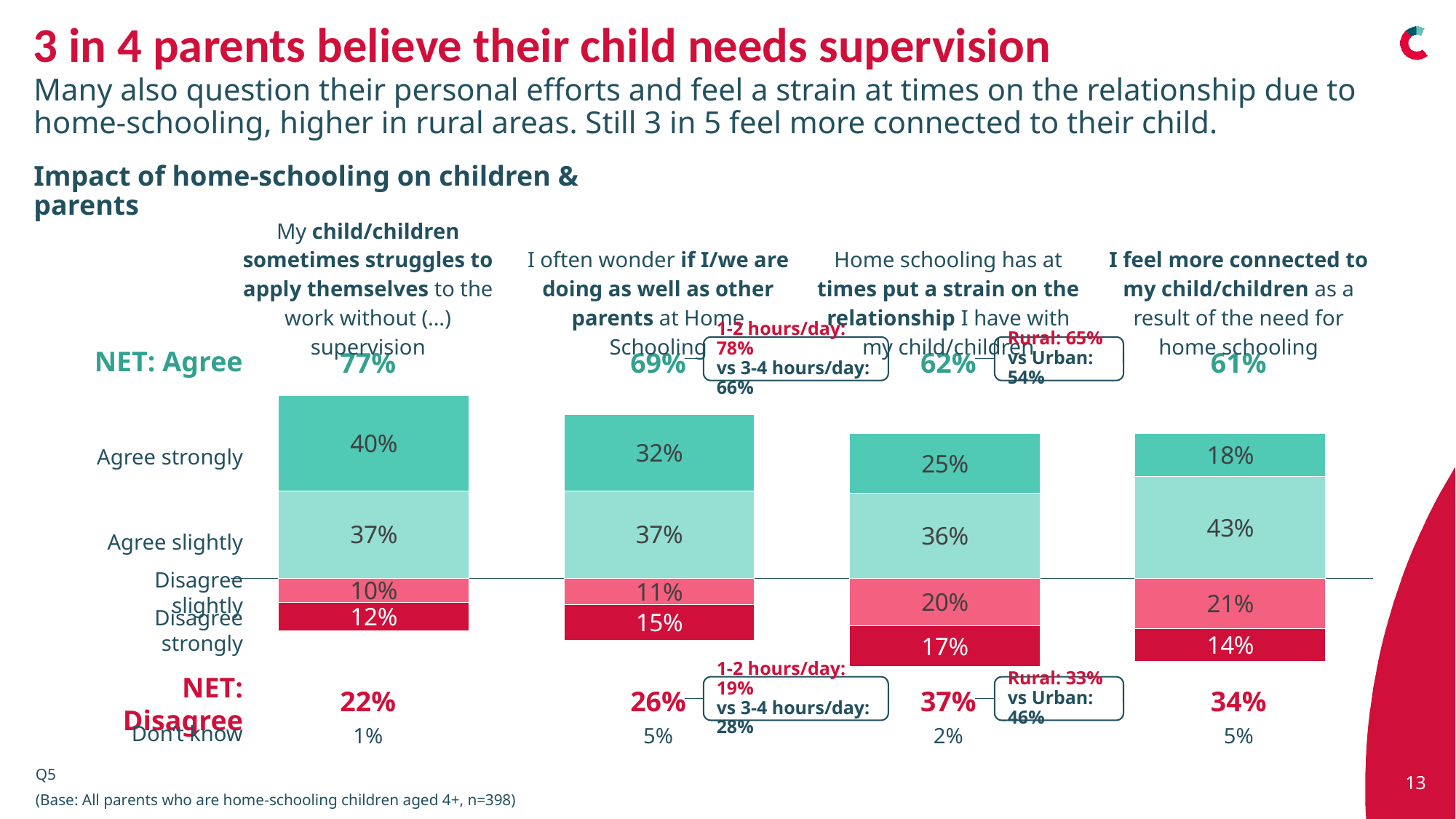
Which statement has the highest NET: Agree value? My child/children sometimes struggles to apply themselves to the work without supervision How many statements are shown in the chart? 4 What kind of chart is used to show the impact of home-schooling on children and parents? Stacked bar chart For the statement that home schooling has at times put a strain on the relationship, what is the difference between NET: Agree and NET: Disagree? 25 percentage points What is the NET: Agree value for the statement that the child/children sometimes struggles to apply themselves to the work without supervision? 77% What percentage of parents answered 'Don't know' for the statement 'I often wonder if I/we are doing as well as other parents at Home Schooling'? 5% Which has a larger 'Agree slightly' share: the statement about feeling more connected to the child, or the statement about the child struggling to apply themselves? I feel more connected to my child/children According to the callout, what are the Rural and Urban NET: Agree values for the statement about home schooling putting a strain on the relationship? Rural: 65% vs Urban: 54% Which statement has the lowest 'Agree strongly' percentage? I feel more connected to my child/children as a result of the need for home schooling What percentage of parents disagree strongly that home schooling has at times put a strain on the relationship with their child/children? 17% What percentage of parents agree strongly that they feel more connected to their child/children as a result of home schooling? 18% What is the combined 'Disagree slightly' and 'Disagree strongly' share for the statement that the child/children sometimes struggles to apply themselves? 22%